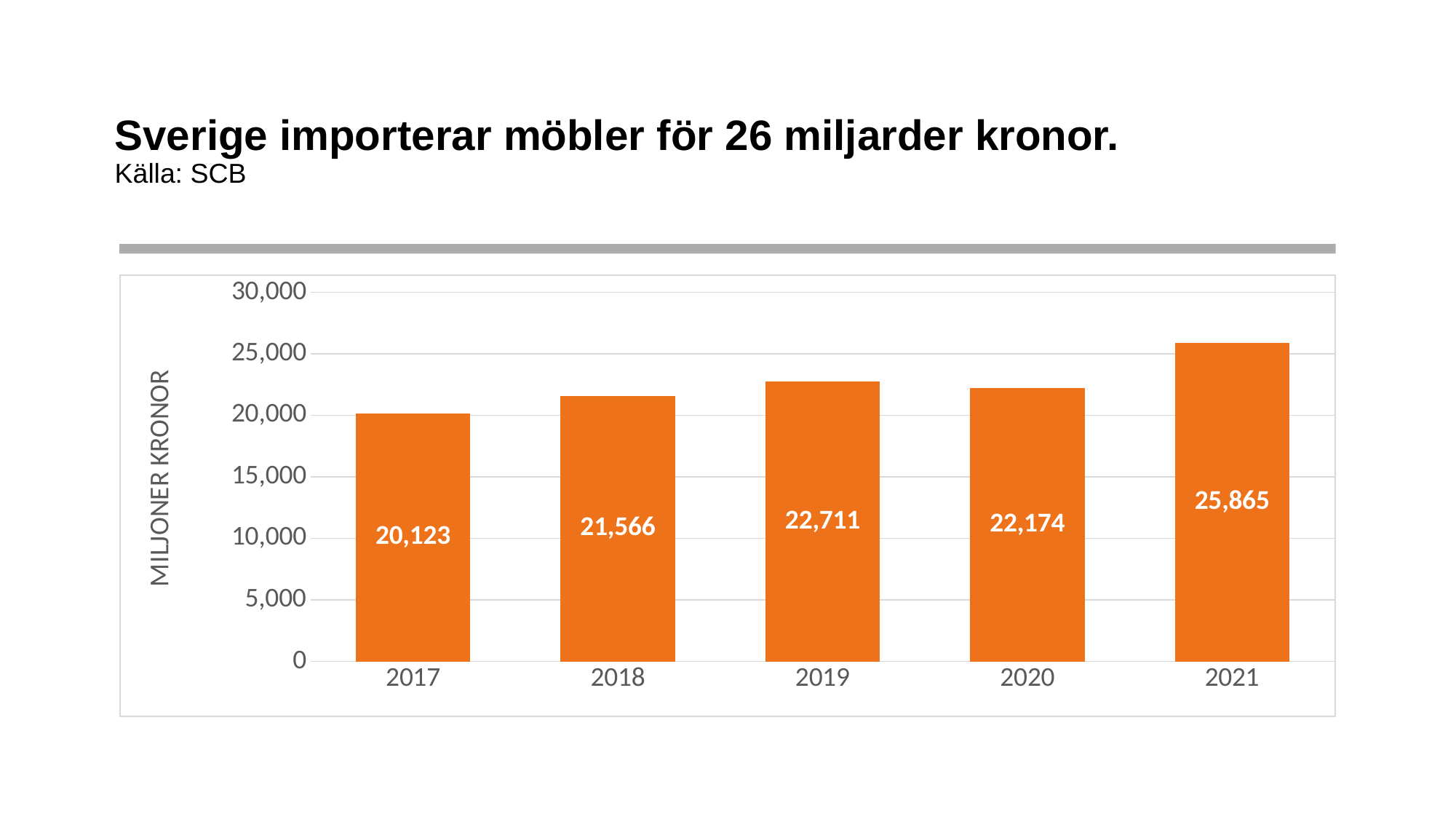
How many years are shown on the x axis? 5 Which is larger, the value for 2018 or the value for 2020? 2020 What is the difference between the values for 2021 and 2017? 5,742 What is the label on the vertical axis? MILJONER KRONOR Which year has the lowest value? 2017 What is the difference between the values for 2019 and 2020? 537 Which year has the highest value? 2021 What is the value for 2017? 20,123 What kind of chart is shown on the slide? bar chart What is the value for 2019? 22,711 What is the value for 2021? 25,865 Is the value for 2021 greater or less than 25,000? greater